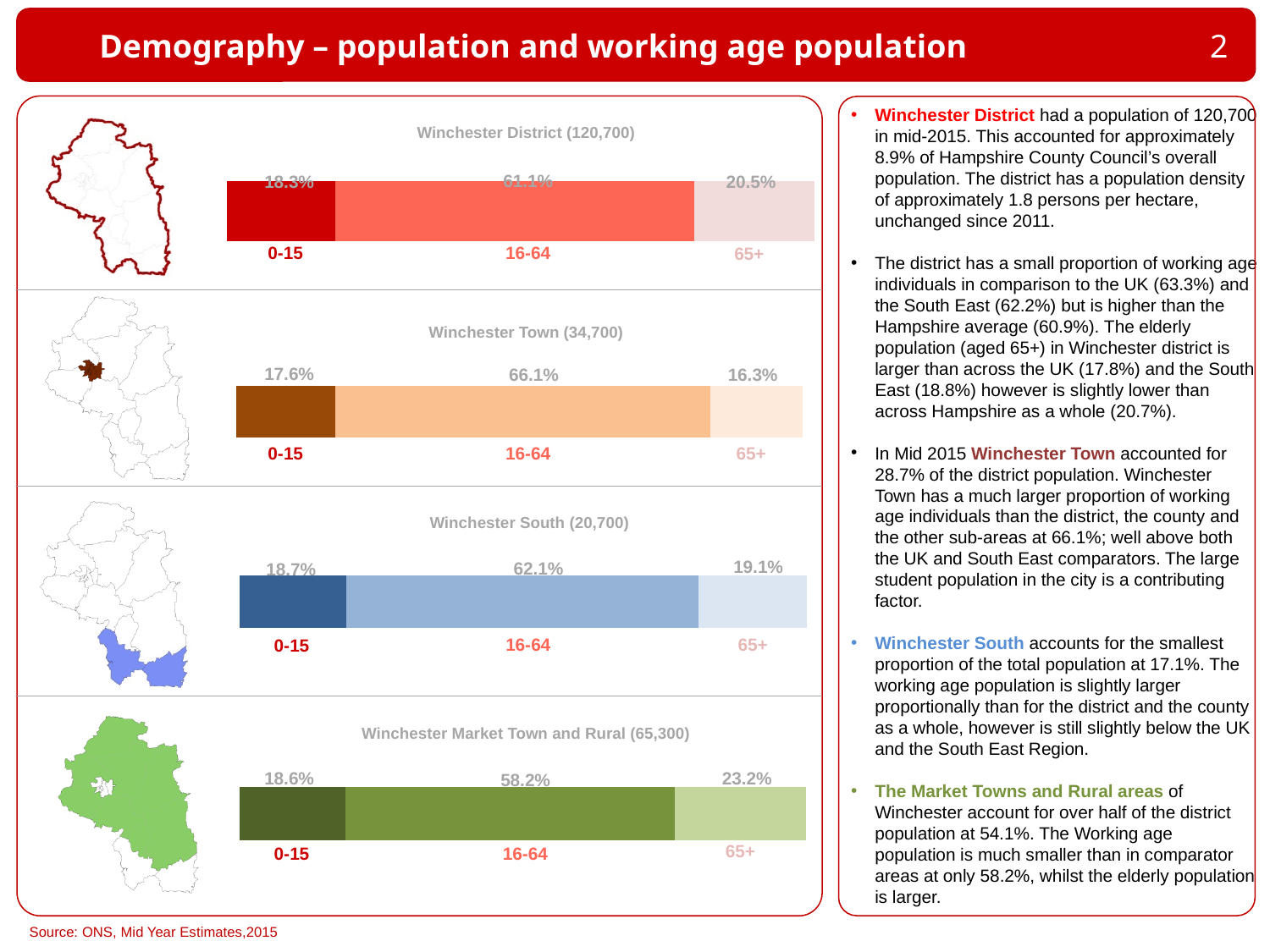
What population figure is shown in the title of the Winchester South chart? 20,700 In the Winchester Market Town and Rural (65,300) chart, which age group has the smallest share? 0-15 In the Winchester District (120,700) chart, what percentage of the population is aged 16-64? 61.1% In the Winchester Town (34,700) chart, what percentage of the population is aged 65+? 16.3% How many age-group segments does each bar on the slide contain? 3 In the Winchester Town (34,700) chart, which age group has the largest share? 16-64 What is the total of the three segments in the Winchester Market Town and Rural (65,300) bar? 100% In the Winchester District (120,700) chart, what is the difference between the 65+ share and the 0-15 share? 2.2% In the Winchester Market Town and Rural (65,300) chart, what percentage of the population is aged 65+? 23.2% In the Winchester South (20,700) chart, which is larger: the 0-15 share or the 65+ share? 65+ In the Winchester South (20,700) chart, what percentage of the population is aged 0-15? 18.7% What type of chart is used for Winchester Town (34,700)? Stacked bar chart